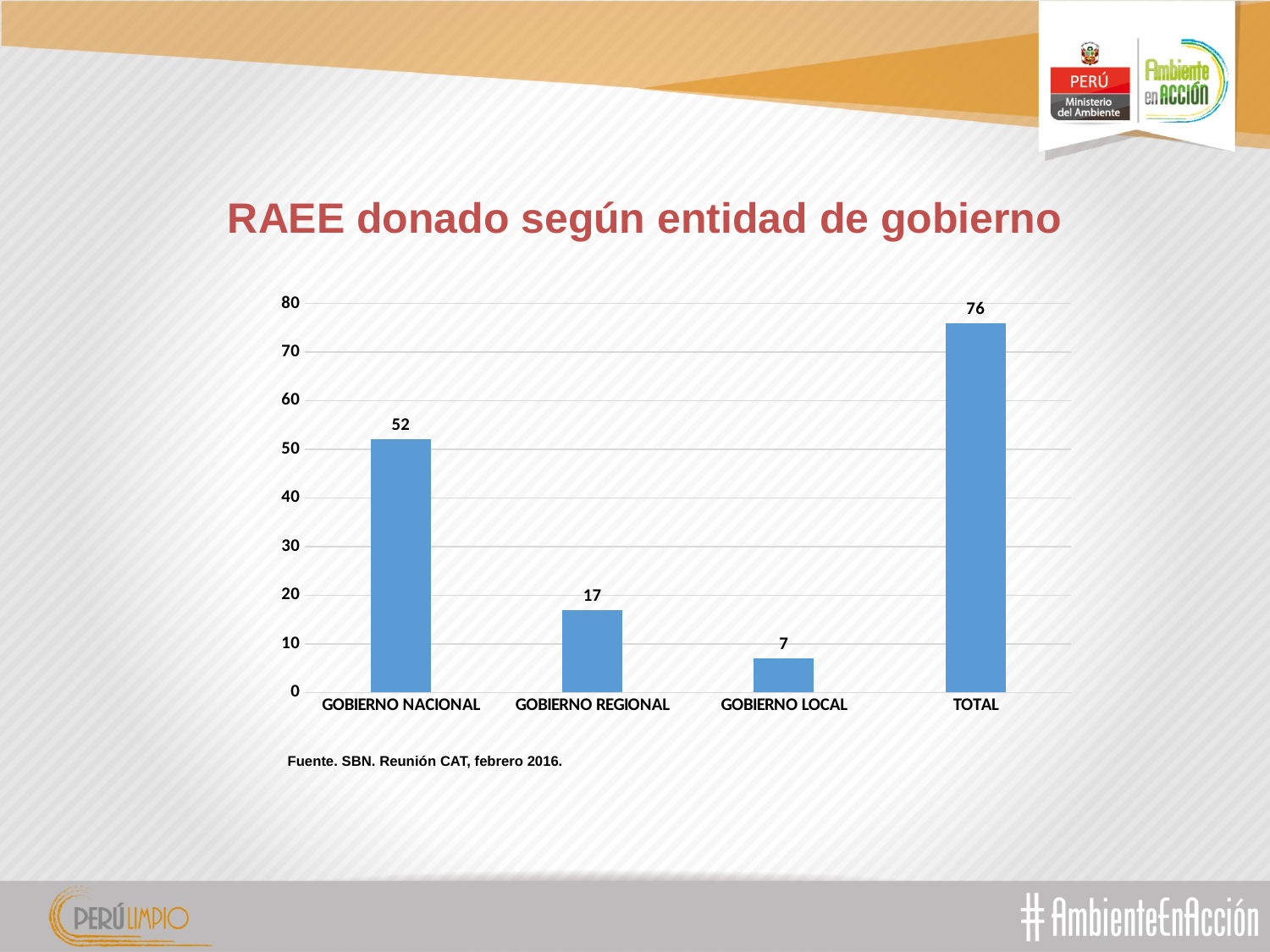
What kind of chart is shown on the slide? bar chart What is the difference between the values for GOBIERNO NACIONAL and GOBIERNO REGIONAL? 35 What is the value for TOTAL? 76 Which category has the highest value? TOTAL Is the value for GOBIERNO NACIONAL greater or less than 50? greater What is the title of the chart? RAEE donado según entidad de gobierno What is the value for GOBIERNO NACIONAL? 52 What is the value for GOBIERNO REGIONAL? 17 Which is larger, the value for GOBIERNO REGIONAL or GOBIERNO LOCAL? GOBIERNO REGIONAL How many categories are shown on the x axis? 4 Which category has the lowest value? GOBIERNO LOCAL What is the value for GOBIERNO LOCAL? 7